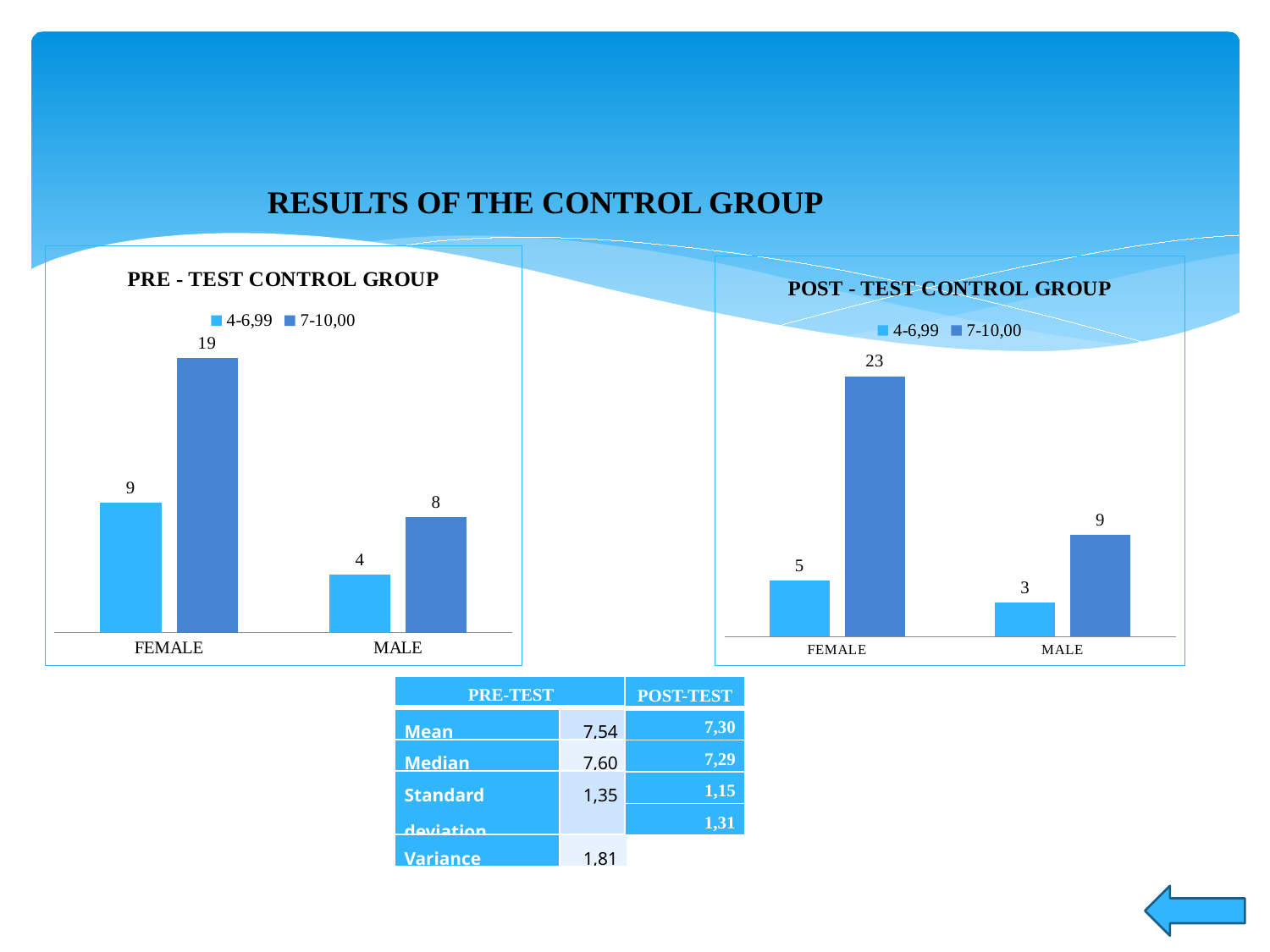
In the PRE - TEST CONTROL GROUP chart, which is larger for FEMALE: the 4-6,99 value or the 7-10,00 value? 7-10,00 In the POST - TEST CONTROL GROUP chart, which bar is the lowest? MALE (4-6,99) In the POST - TEST CONTROL GROUP chart, what is the difference between the 7-10,00 and 4-6,99 values for FEMALE? 18 How many categories are shown on the x axis of the PRE - TEST CONTROL GROUP chart? 2 In the POST - TEST CONTROL GROUP chart, what is the value for MALE in the 4-6,99 series? 3 In the PRE - TEST CONTROL GROUP chart, what is the value for MALE in the 4-6,99 series? 4 In the POST - TEST CONTROL GROUP chart, what is the value for FEMALE in the 7-10,00 series? 23 What kind of chart is the POST - TEST CONTROL GROUP chart? Bar chart How many series does the legend of the POST - TEST CONTROL GROUP chart list? 2 In the PRE - TEST CONTROL GROUP chart, what is the value for FEMALE in the 7-10,00 series? 19 In the PRE - TEST CONTROL GROUP chart, what is the difference between the FEMALE and MALE values in the 7-10,00 series? 11 In the PRE - TEST CONTROL GROUP chart, which category has the highest bar? FEMALE (7-10,00)